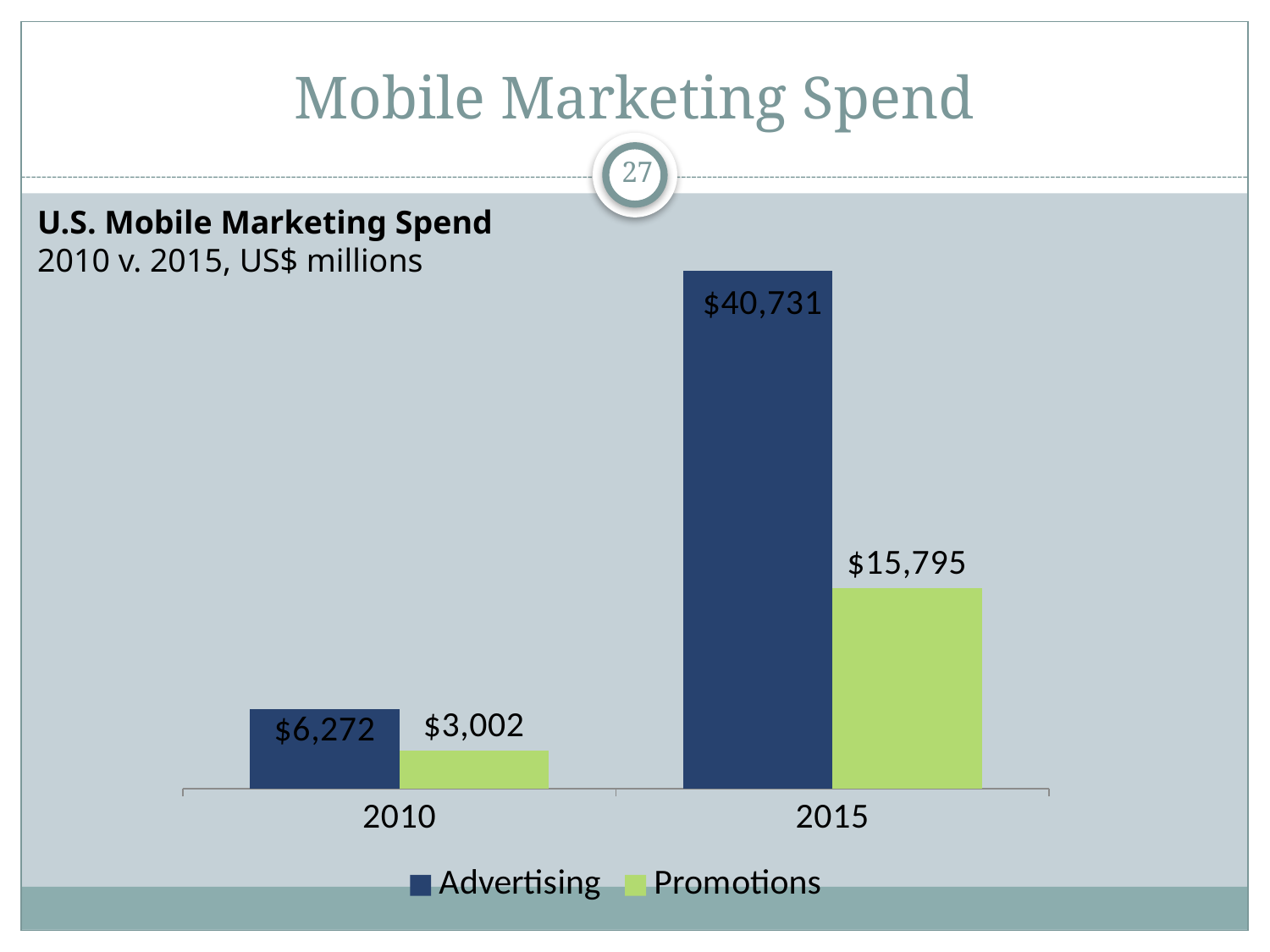
Which bar has the lowest value on the chart? Promotions in 2010 What is the difference between Advertising and Promotions in 2015? $24,936 What is the Promotions value for 2010? $3,002 What is the difference between the Advertising values for 2015 and 2010? $34,459 What is the Advertising value for 2010? $6,272 Which bar has the highest value on the chart? Advertising in 2015 What is the Advertising value for 2015? $40,731 What kind of chart is shown on the slide? Bar chart Which is larger in 2010, Advertising or Promotions? Advertising What is the Promotions value for 2015? $15,795 How many years are shown on the x axis? 2 How many series does the legend list? 2